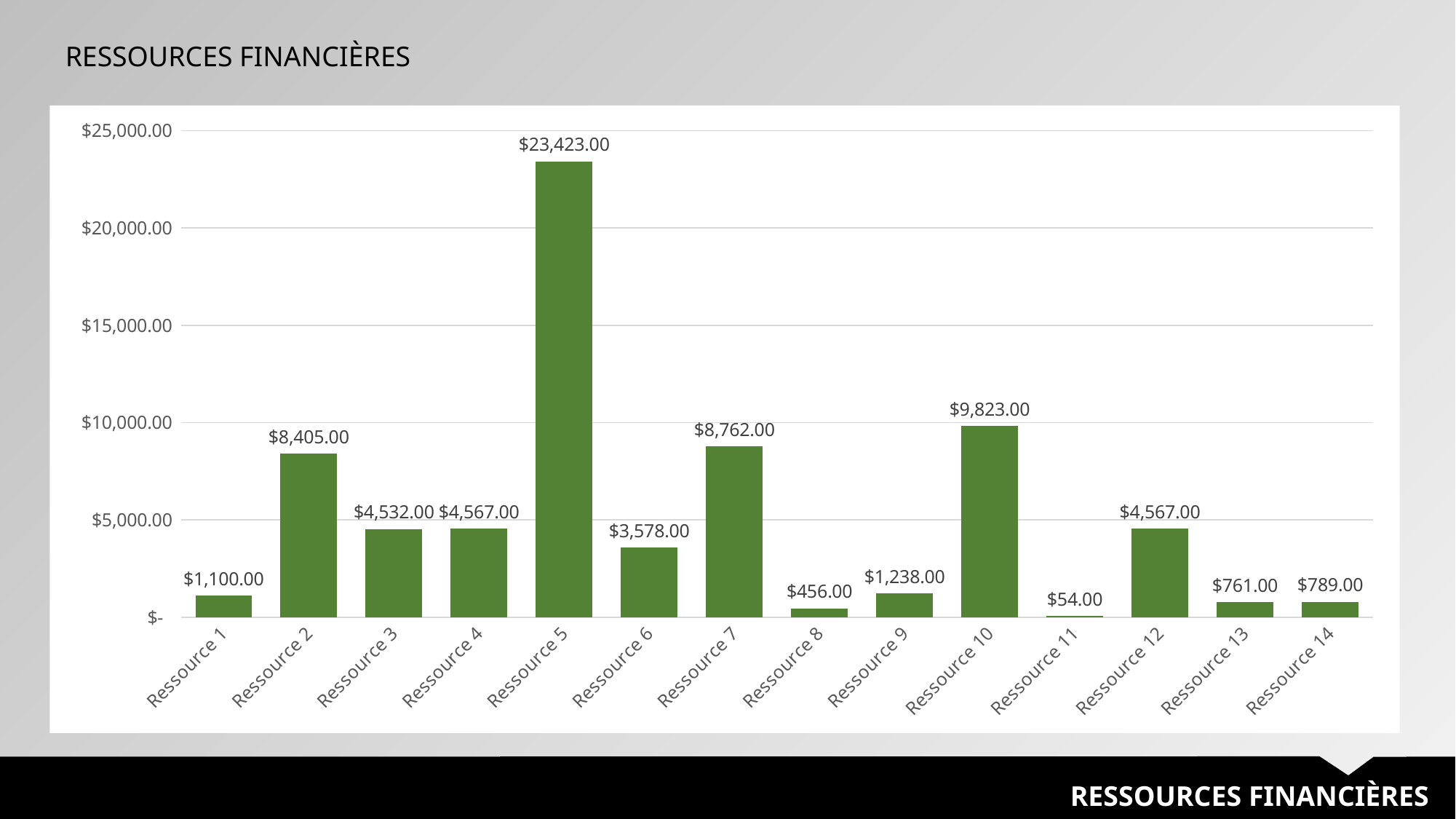
What kind of chart is shown on the slide? bar chart What is the title of the slide? RESSOURCES FINANCIÈRES What is the value for Ressource 10? $9,823.00 What is the value for Ressource 11? $54.00 Which category has the lowest value? Ressource 11 Which category has the highest value? Ressource 5 Which is larger, the value for Ressource 6 or the value for Ressource 9? Ressource 6 What is the difference between the values for Ressource 14 and Ressource 13? $28.00 Is the value for Ressource 10 greater or less than $10,000.00? less How many categories are shown on the x axis? 14 What is the difference between the values for Ressource 2 and Ressource 7? $357.00 What is the value for Ressource 5? $23,423.00